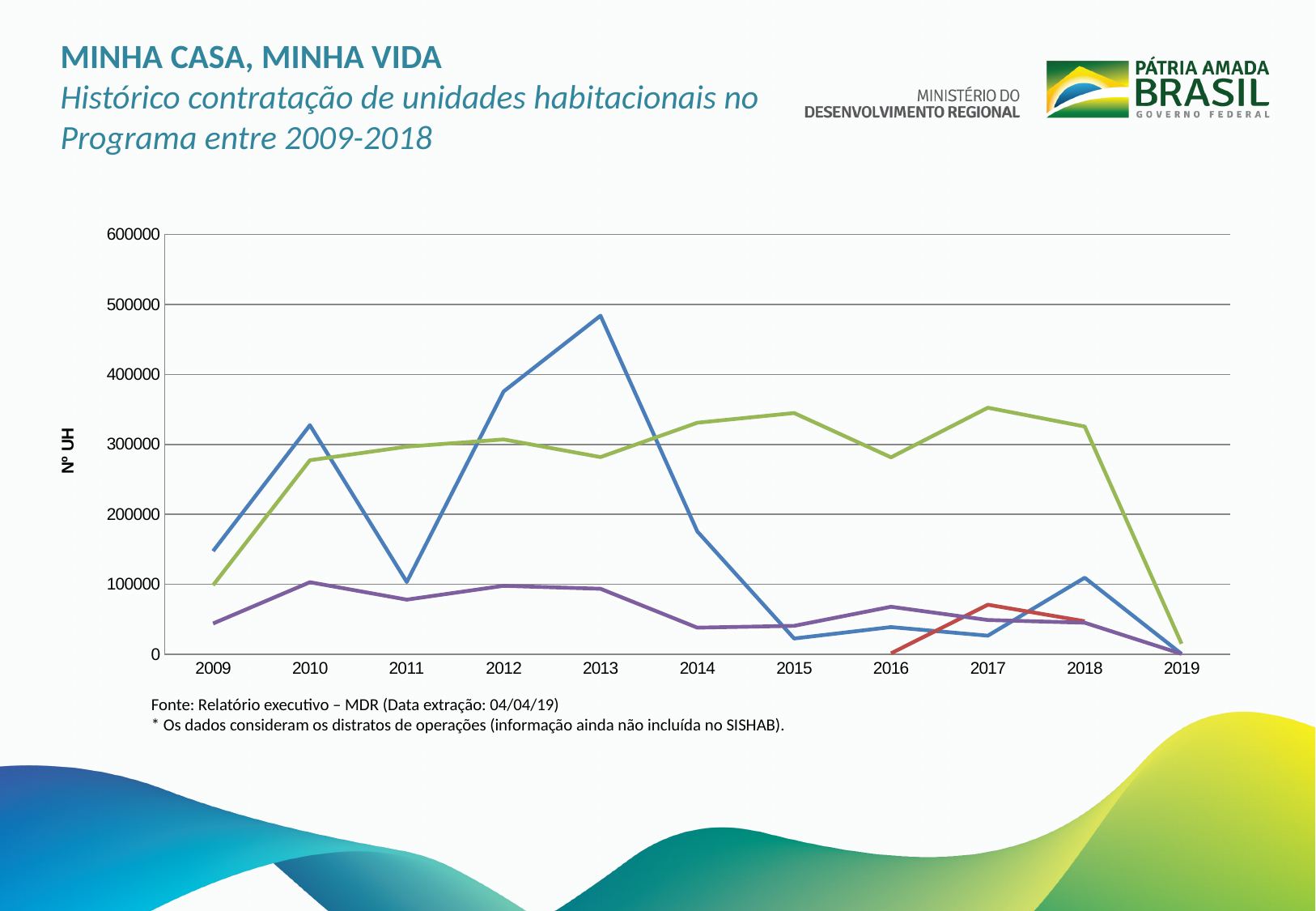
In which year does the blue line reach its highest value? 2013 Is the value of the green line in 2015 greater or less than 300000? greater Does the green line rise or fall between 2018 and 2019? fall Is the value of the blue line in 2013 greater or less than 400000? greater In 2015, which line has the larger value, the blue line or the green line? green line How many years are shown on the x axis of the chart? 11 Is the value of the blue line in 2014 greater or less than 200000? less How many lines are plotted on the chart? 4 What kind of chart is shown on the slide? line chart In which year does the green line reach its lowest value? 2019 What is the label of the y axis? Nº UH